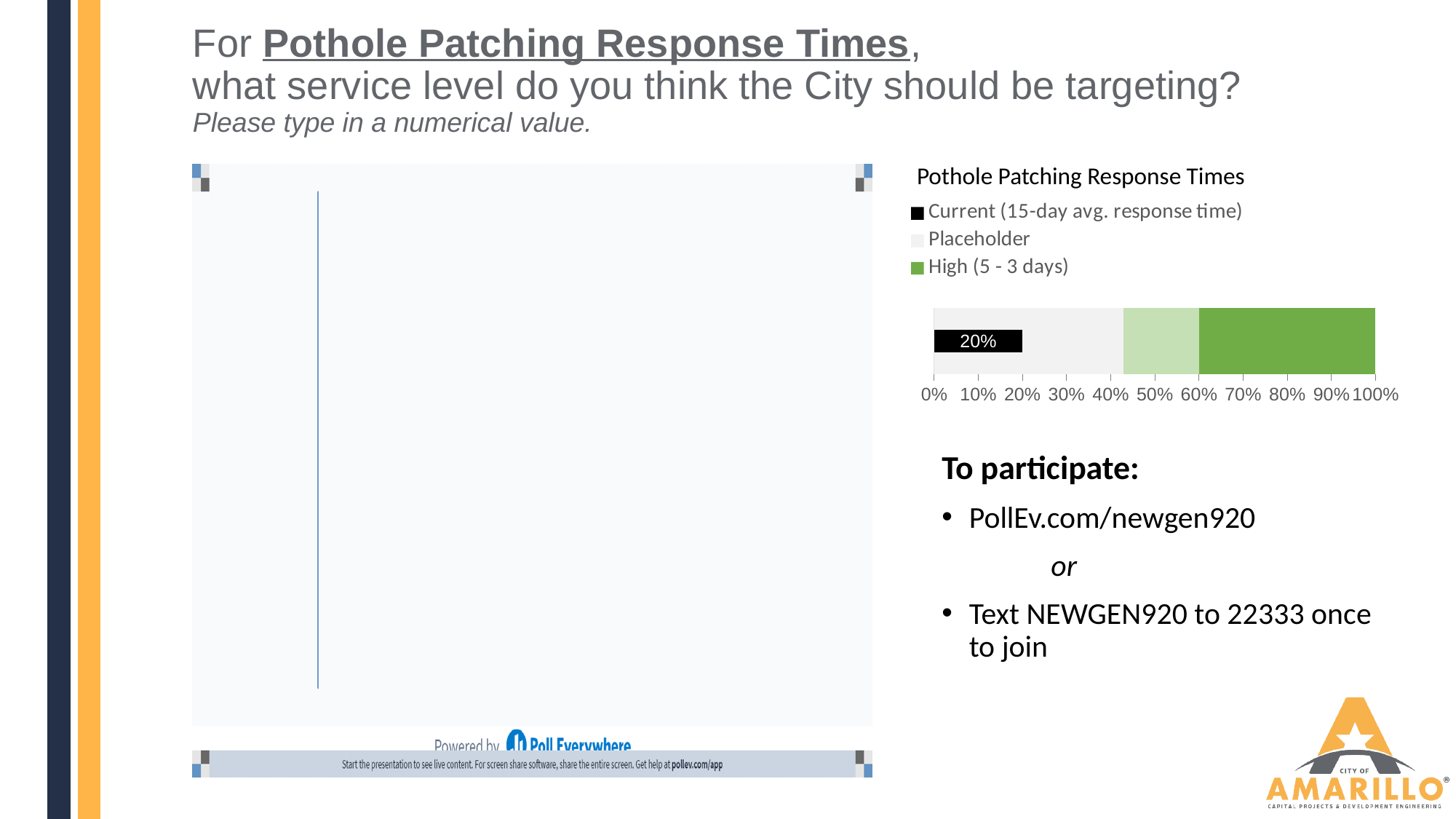
In the Pothole Patching Response Times chart, is the value for Current (15-day avg. response time) greater or less than 50%? less In the Pothole Patching Response Times chart, is the value for Current (15-day avg. response time) greater or less than 30%? less How many series does the legend of the Pothole Patching Response Times chart list? 3 What kind of chart is the Pothole Patching Response Times chart? bar chart In the Pothole Patching Response Times chart, is the value for Current (15-day avg. response time) greater or less than 10%? greater What colour represents Current (15-day avg. response time) in the Pothole Patching Response Times chart legend? black What value is labelled on the Current (15-day avg. response time) bar in the Pothole Patching Response Times chart? 20% What is the title of the chart on the right side of the slide? Pothole Patching Response Times